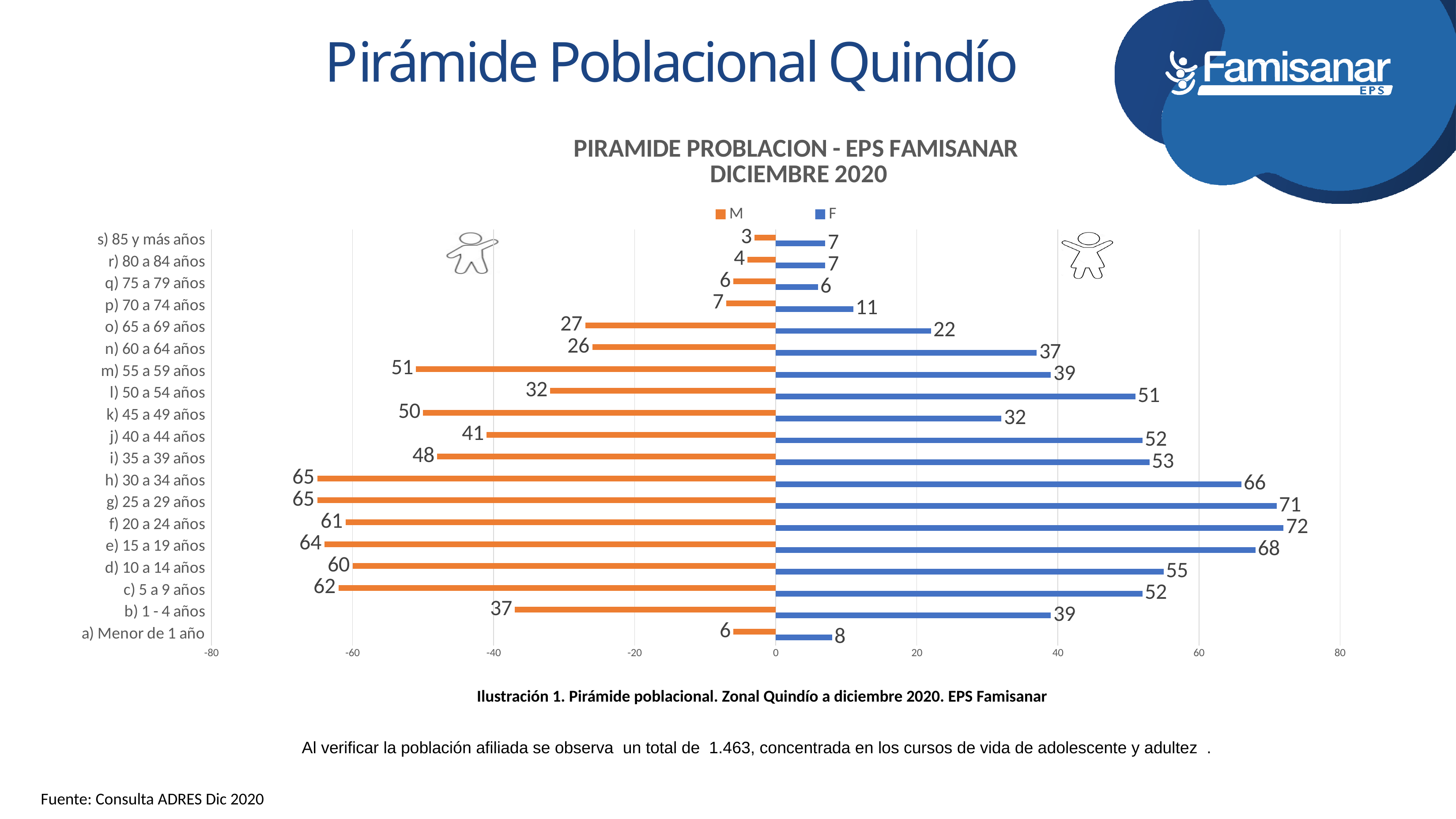
What is the difference between the F and M values in the age group l) 50 a 54 años? 19 What kind of chart is shown on the slide? Bar chart What is the value for M in the age group a) Menor de 1 año? 6 How many series does the legend list? 2 What is the title of the chart? PIRAMIDE PROBLACION - EPS FAMISANAR DICIEMBRE 2020 What is the value for M in the age group m) 55 a 59 años? 51 Which age group has the lowest value for the M series? s) 85 y más años Which age group has the highest value for the F series? f) 20 a 24 años What is the total of M and F in the age group h) 30 a 34 años? 131 What is the value for F in the age group f) 20 a 24 años? 72 In the age group k) 45 a 49 años, which series has the larger value, M or F? M How many age groups are shown on the chart? 19